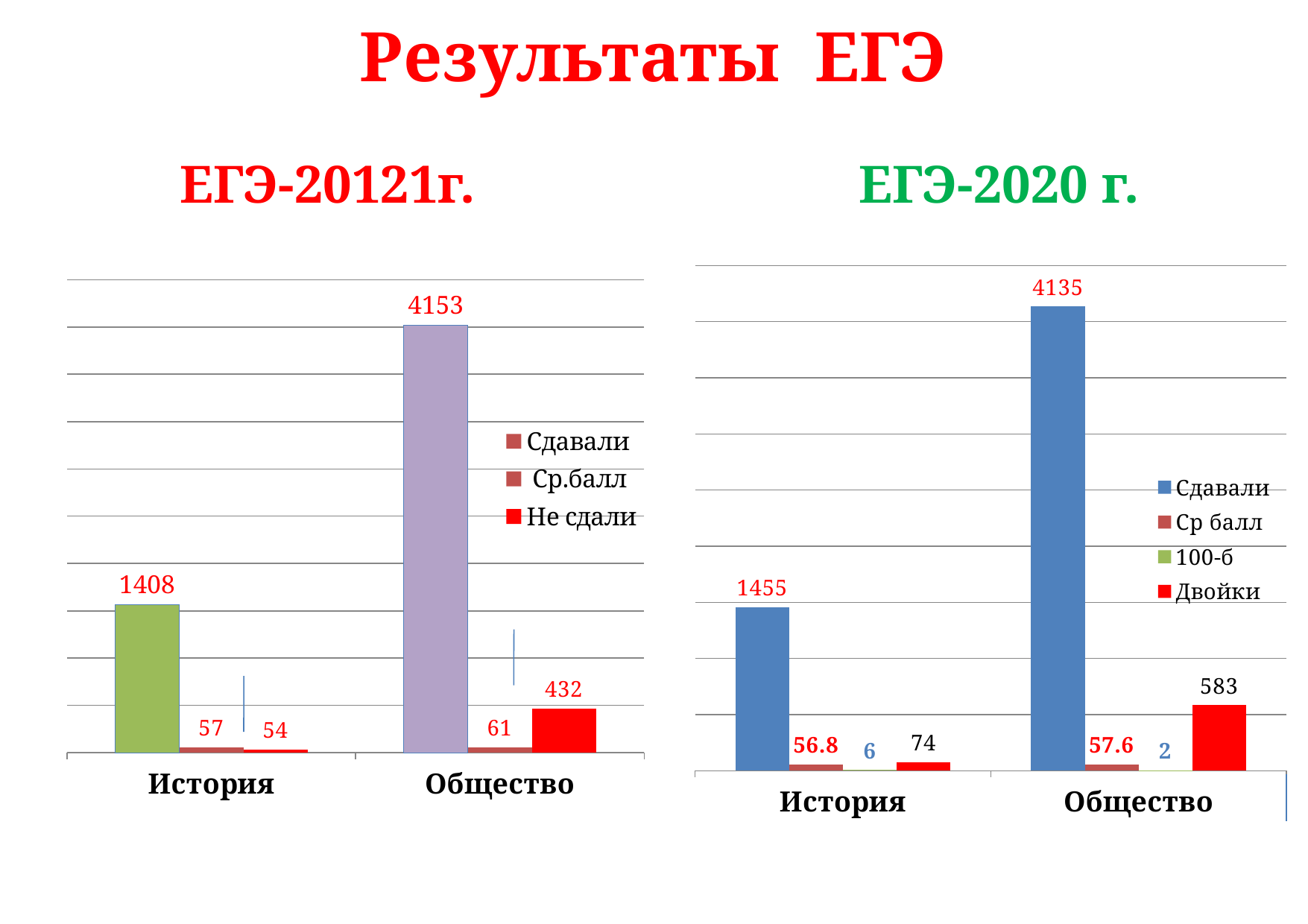
In the ЕГЭ-2020 г. chart, what is the 100-б value for Общество? 2 In the ЕГЭ-20121г. chart, how many series does the legend list? 3 In the ЕГЭ-2020 г. chart, which category has the higher Двойки value, История or Общество? Общество In the ЕГЭ-20121г. chart, what is the difference between the Сдавали values for Общество and История? 2745 In the ЕГЭ-20121г. chart, what is the Ср.балл value for Общество? 61 What type of chart is the ЕГЭ-2020 г. chart? Bar chart In the ЕГЭ-2020 г. chart, what is the Двойки value for История? 74 In the ЕГЭ-20121г. chart, what is the Сдавали value for История? 1408 In the ЕГЭ-2020 г. chart, what is the Сдавали value for Общество? 4135 In the ЕГЭ-2020 г. chart, what is the Ср балл value for История? 56.8 In the ЕГЭ-2020 г. chart, how many series does the legend list? 4 In the ЕГЭ-20121г. chart, what is the Не сдали value for Общество? 432